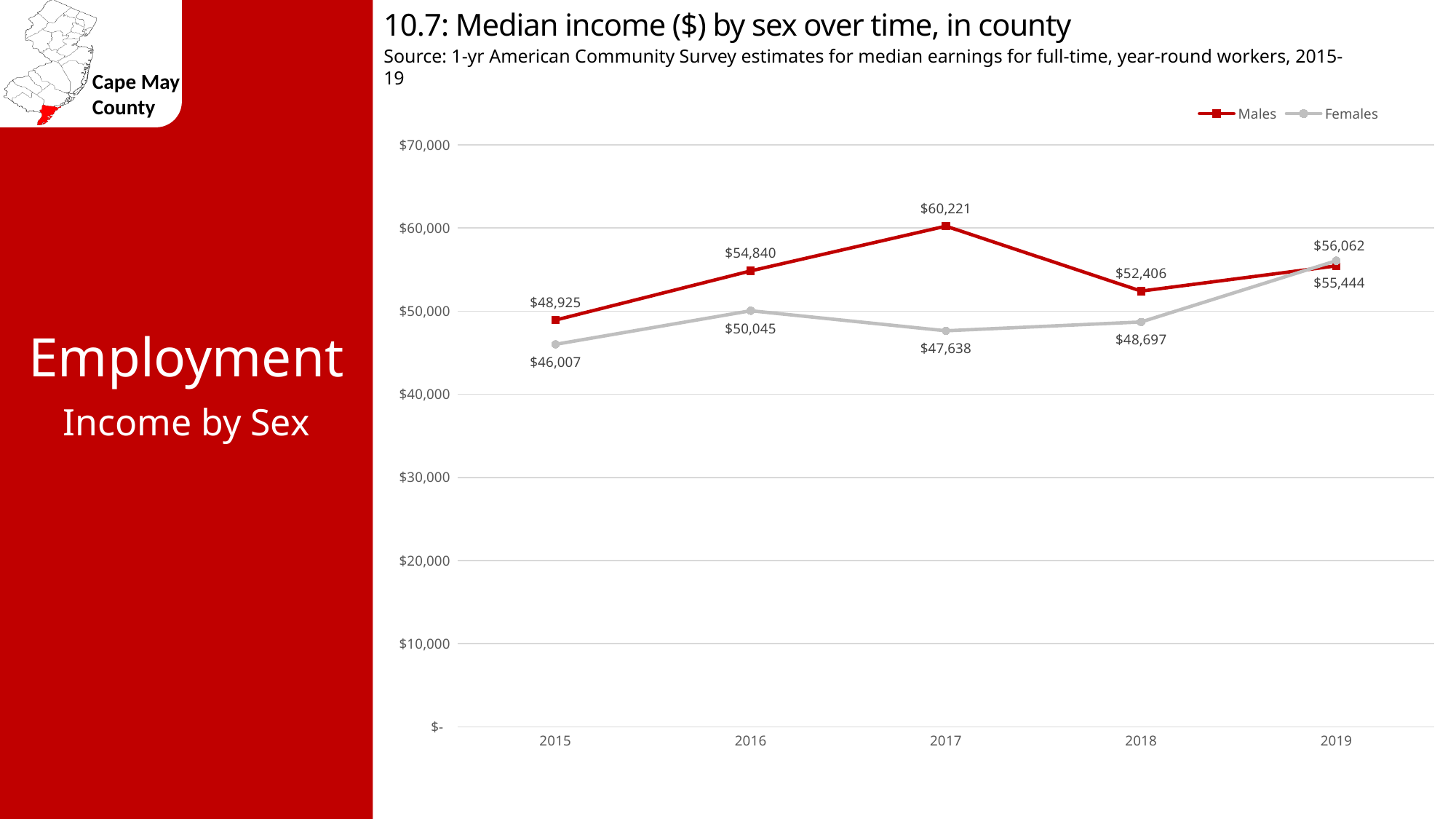
What was the median income for females in 2019? $56,062 In which year was the median income for females lowest? 2015 What was the median income for males in 2017? $60,221 How many years are shown on the x axis? 5 In which year was the median income for males highest? 2017 Did the median income for males rise or fall from 2017 to 2018? Fall How many series does the legend list? 2 What was the median income for females in 2015? $46,007 What is the difference between male and female median income in 2017? $12,583 What kind of chart is shown on the slide? Line chart What is the difference between male and female median income in 2015? $2,918 In 2019, which group had the higher median income, males or females? Females